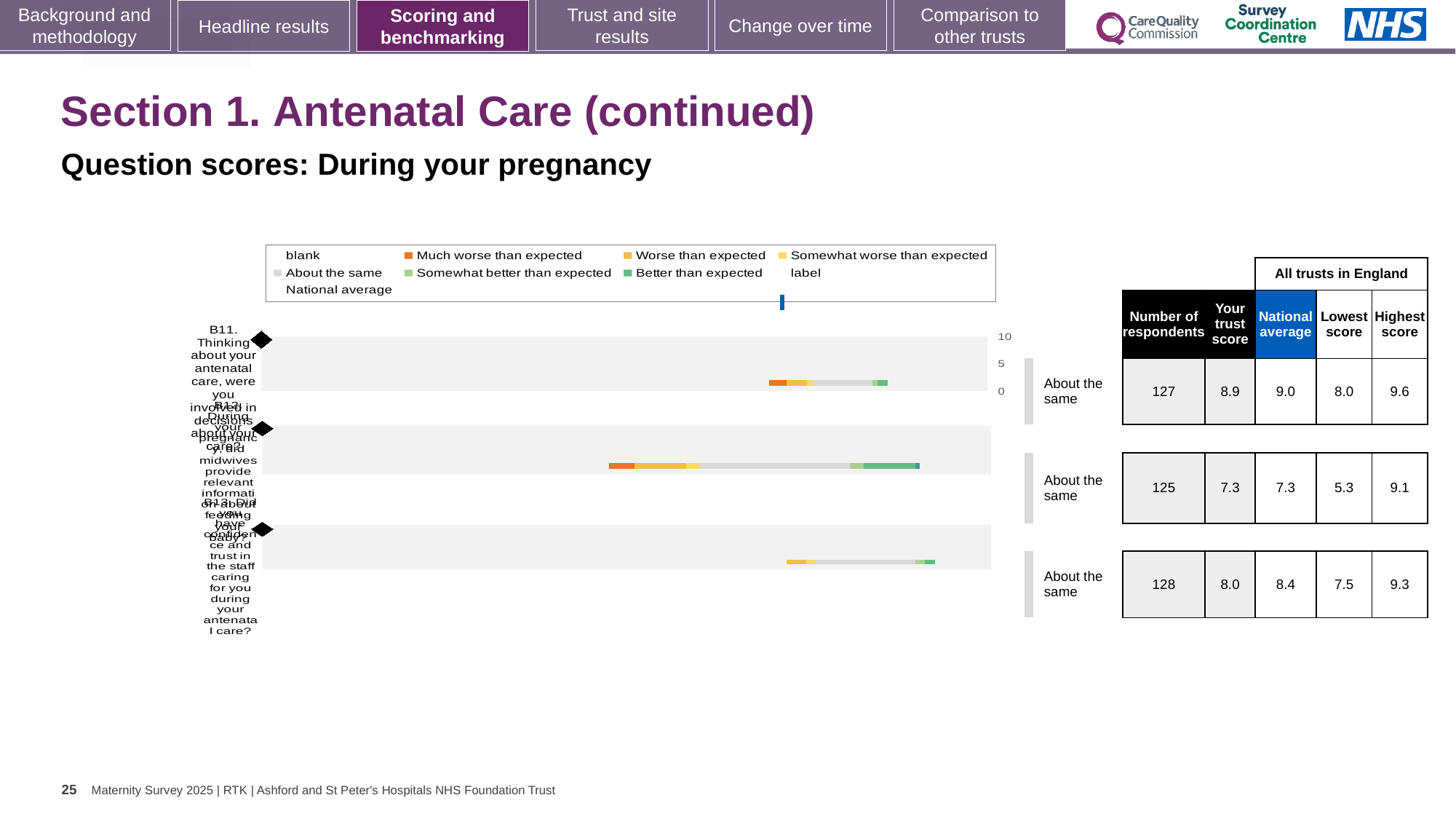
How many question bars (B11, B12, B13) are plotted in the chart? 3 What is the highest score among all trusts in England for question B11? 9.6 Which question has the highest trust score: B11, B12 or B13? B11 What is the number of respondents for question B11? 127 How many legend entries are listed above the chart? 9 What is the difference between the national average and the trust score for question B13? 0.4 What benchmark category is shown next to each of the three question bars? About the same What is the lowest score among all trusts in England for question B12? 5.3 What is the national average for question B13? 8.4 What kind of chart is shown on the slide? bar chart What is the trust score for question B12? 7.3 Which question has the lowest trust score: B11, B12 or B13? B12